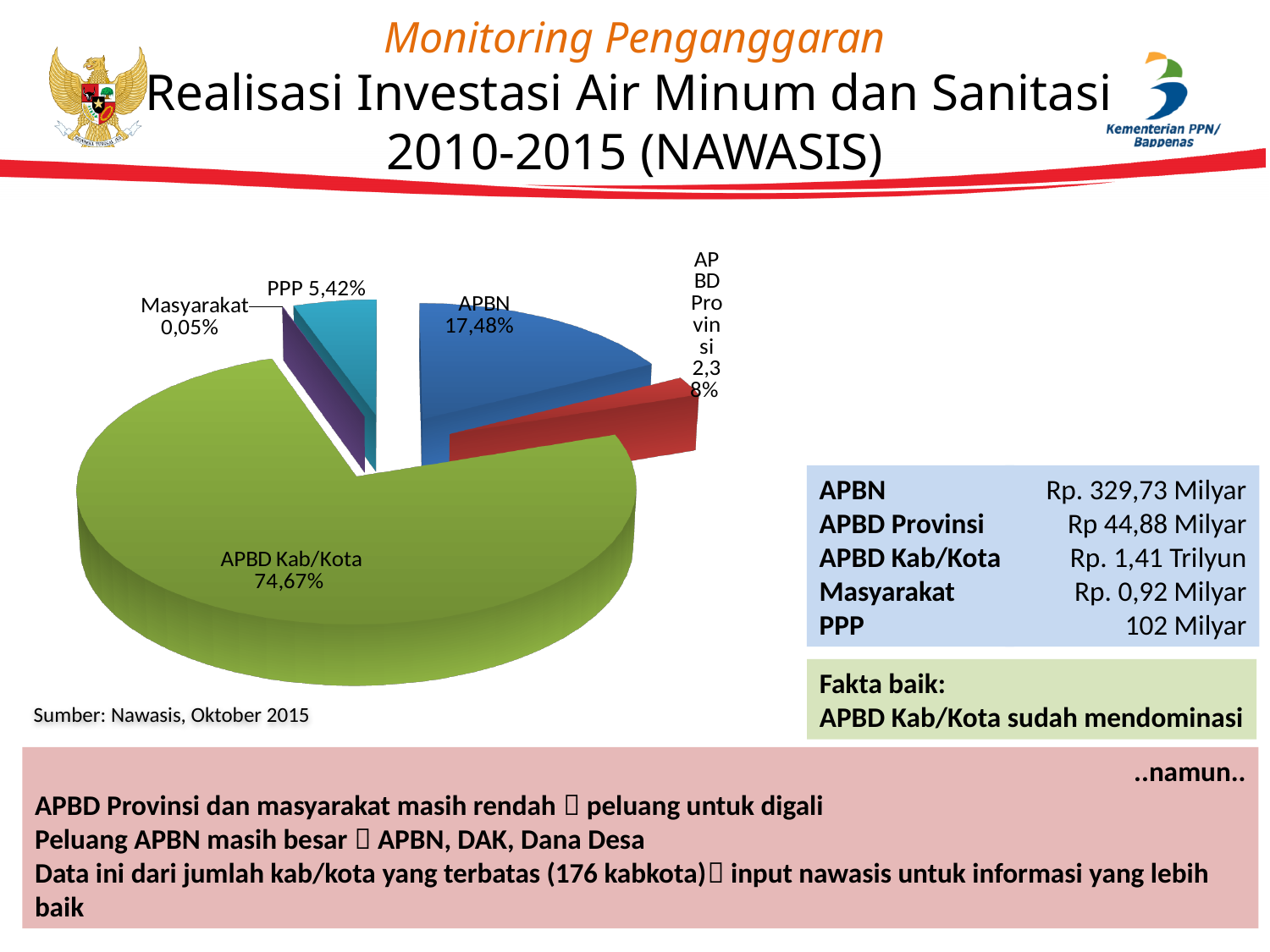
How many slices does the pie chart have? 5 Which category has the largest slice of the pie? APBD Kab/Kota What source is cited below the pie chart? Nawasis, Oktober 2015 What share of the pie does APBD Kab/Kota hold? 74,67% What percentage is shown for PPP in the pie chart? 5,42% What percentage is shown for Masyarakat in the pie chart? 0,05% What type of chart is shown on the slide? pie chart Which slice is larger, PPP or APBD Provinsi? PPP What percentage is shown for APBN in the pie chart? 17,48% Which slice is larger, APBN or PPP? APBN What is the difference in percentage points between the APBD Kab/Kota slice and the APBN slice? 57,19 Which category has the smallest slice of the pie? Masyarakat